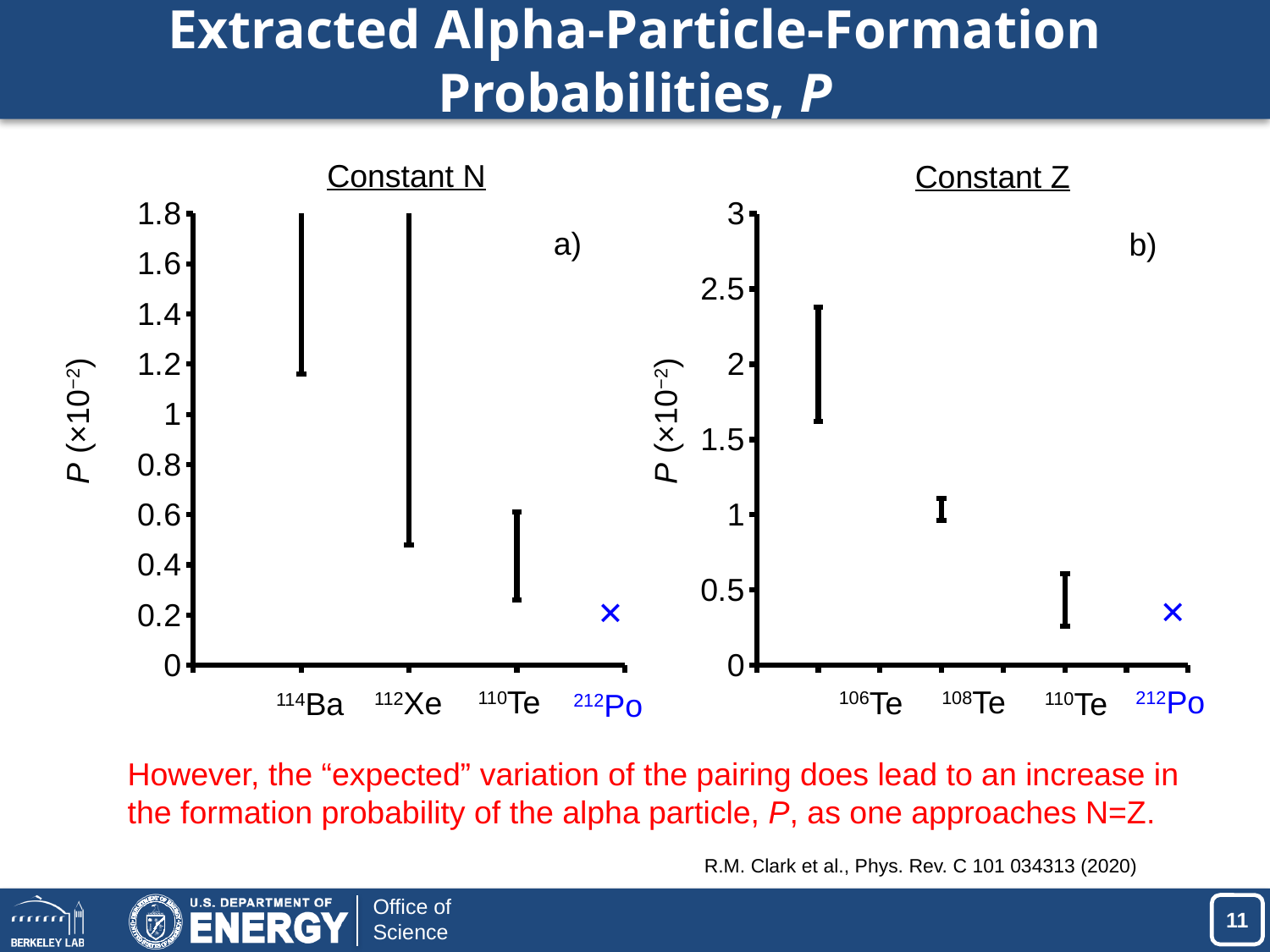
On the Constant N chart, which isotope has the lowest value of P? 212Po Which isotope is shown in blue on both charts? 212Po How many isotopes are plotted on the Constant Z chart? 4 On the Constant N chart, is the value for 110Te greater or less than 0.8? less On the Constant Z chart, is the value for 212Po greater or less than 0.5? less On the Constant N chart, is the value for 114Ba greater or less than 1? greater What is the y-axis label on the Constant Z chart? P (×10⁻²) On the Constant Z chart, which isotope has the highest value of P? 106Te How many isotopes are plotted on the Constant N chart? 4 On the Constant Z chart, which has the larger value of P, 106Te or 110Te? 106Te On the Constant N chart, do the values of P generally rise or fall from left to right along the x axis? fall